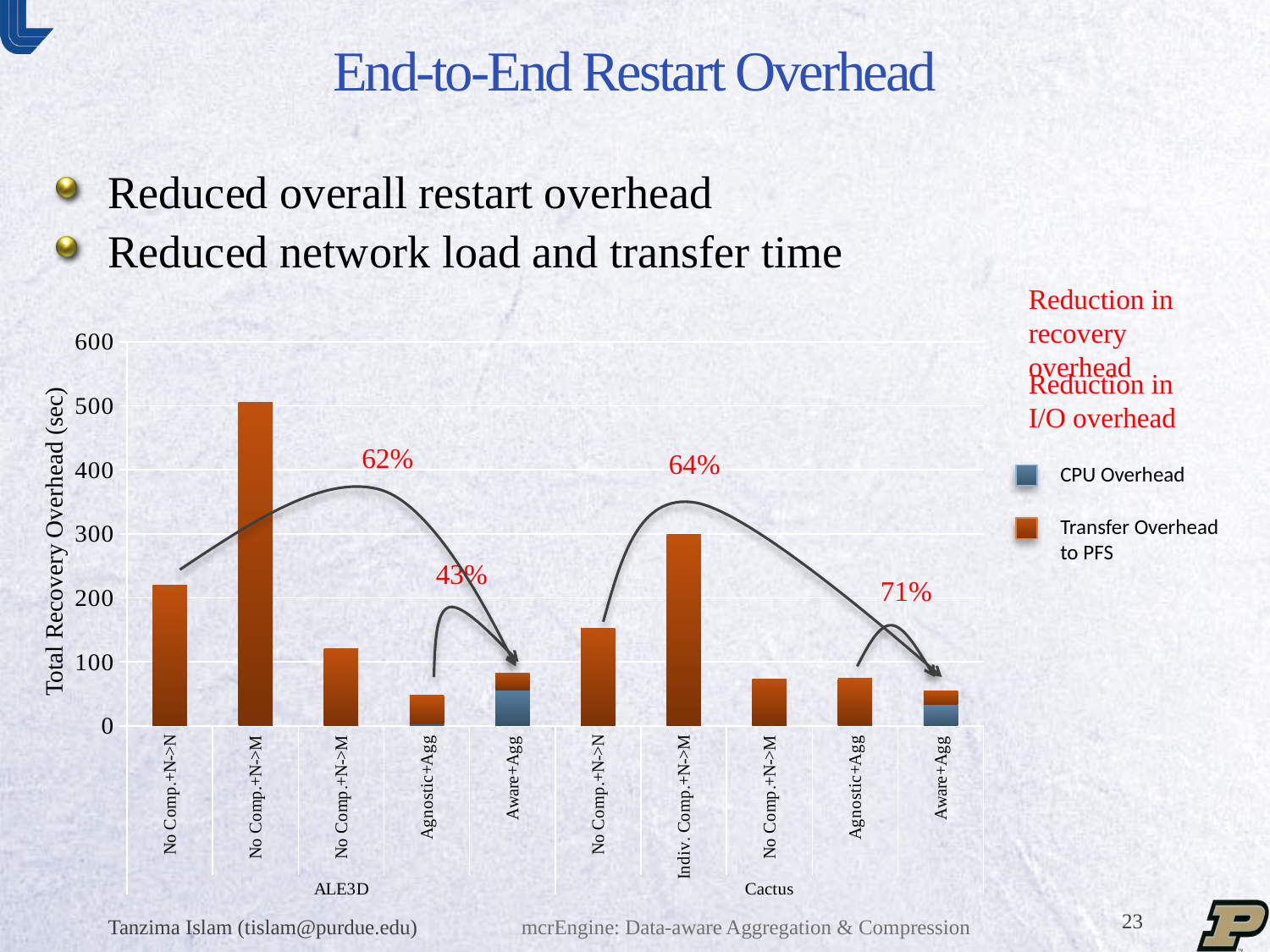
Is the total recovery overhead for the tallest ALE3D bar (No Comp.+N->M) greater or less than 400? greater Is the total recovery overhead for No Comp.+N->N under Cactus greater or less than 100? greater Is the total recovery overhead for Indiv. Comp.+N->M under Cactus greater or less than 200? greater What kind of chart is shown on the slide? Stacked bar chart What are the two series named in the chart legend? CPU Overhead and Transfer Overhead to PFS Which two application groups are labelled along the x axis of the chart? ALE3D and Cactus Which has the larger total recovery overhead: No Comp.+N->N under Cactus or Agnostic+Agg under ALE3D? No Comp.+N->N under Cactus How many bars are plotted in the chart in total? 10 Which has the larger total recovery overhead: No Comp.+N->N under ALE3D or Indiv. Comp.+N->M under Cactus? Indiv. Comp.+N->M under Cactus How many series does the chart legend list? 2 Which bar has the highest total recovery overhead in the chart? No Comp.+N->M (ALE3D)